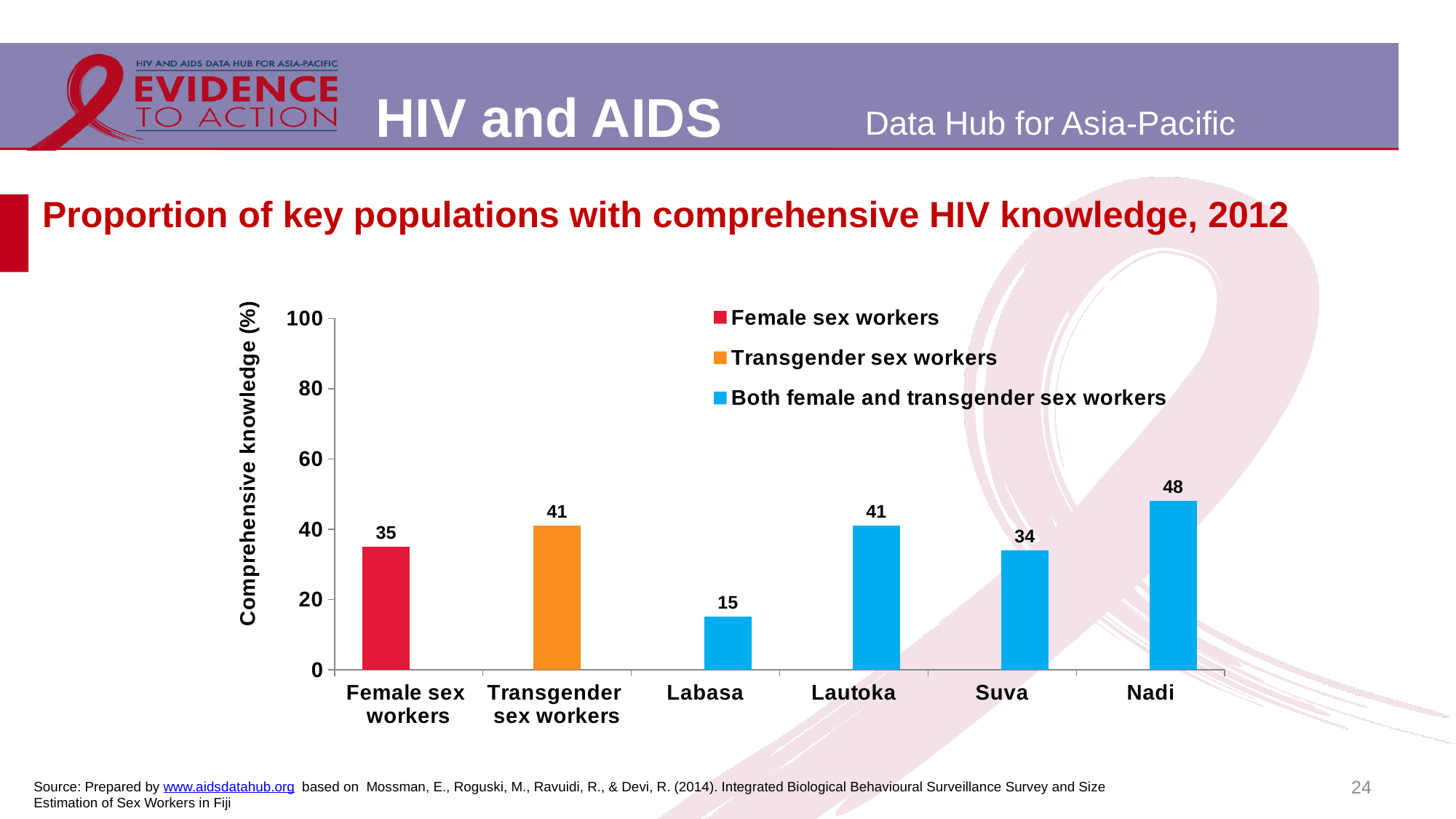
What is the value for Nadi? 48 Which category has the lowest value? Labasa What is the value for Female sex workers? 35 Is the value for Lautoka greater or less than 40? greater How many series does the legend list? 3 What is the label of the y axis? Comprehensive knowledge (%) What is the difference between the values for Nadi and Suva? 14 Which is larger, the value for Transgender sex workers or the value for Female sex workers? Transgender sex workers What is the value for Labasa? 15 Which category has the highest value? Nadi What kind of chart is shown? bar chart How many categories are shown on the x axis? 6